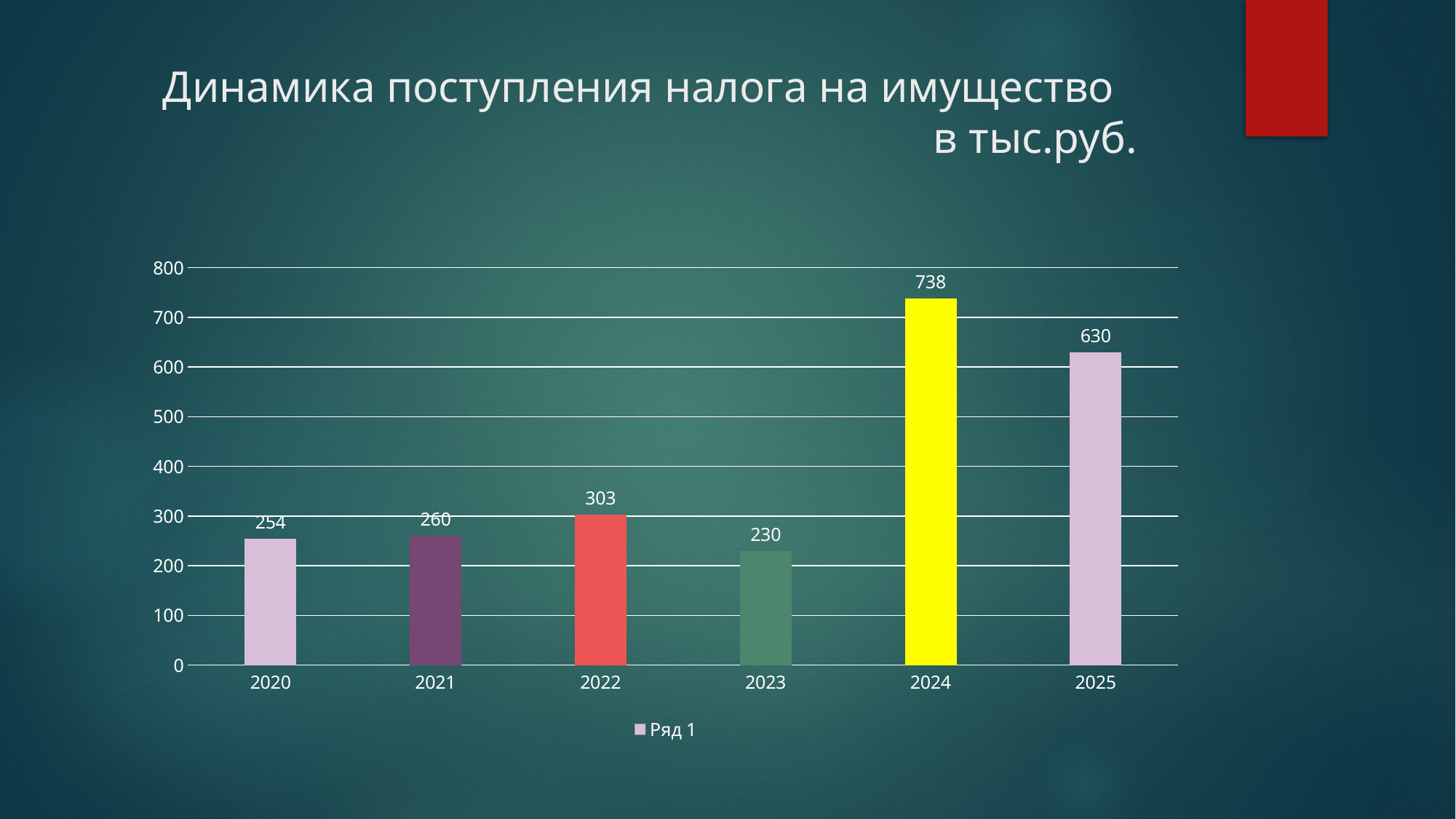
What is the value for 2020? 254 What is the value for 2023? 230 Which is larger, the value for 2022 or the value for 2023? 2022 Which year has the highest value? 2024 What kind of chart is shown on the slide? bar chart Which year has the lowest value? 2023 Is the value for 2025 greater or less than 600? greater What is the difference between the values for 2024 and 2025? 108 How many years are shown on the x axis? 6 What is the name of the series listed in the legend? Ряд 1 What is the difference between the values for 2022 and 2021? 43 What is the value for 2024? 738